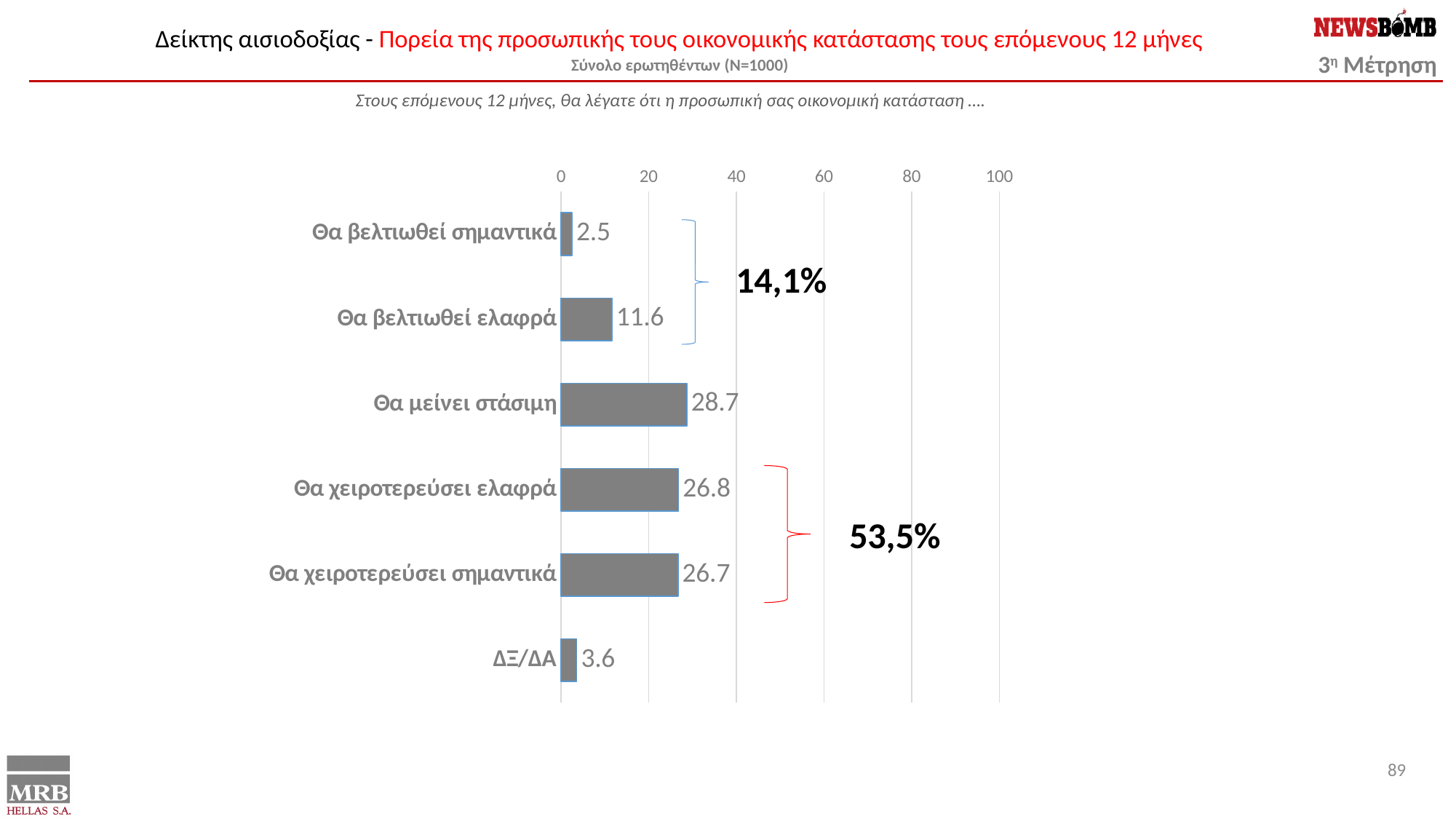
What is the value for "Θα μείνει στάσιμη"? 28.7 Which category has the lowest value? Θα βελτιωθεί σημαντικά How many categories are shown in the chart? 6 Is the value for "Θα χειροτερεύσει ελαφρά" greater or less than 20? greater Which category has the highest value? Θα μείνει στάσιμη Which is larger: the value for "Θα βελτιωθεί ελαφρά" or the value for "ΔΞ/ΔΑ"? Θα βελτιωθεί ελαφρά What combined percentage is shown next to the red bracket grouping the two "Θα χειροτερεύσει" categories? 53,5% What kind of chart is shown on the slide? bar chart What is the difference between the values for "Θα μείνει στάσιμη" and "Θα βελτιωθεί ελαφρά"? 17.1 What combined percentage is shown next to the blue bracket grouping the two "Θα βελτιωθεί" categories? 14,1% What is the value for "Θα βελτιωθεί ελαφρά"? 11.6 What is the value for "ΔΞ/ΔΑ"? 3.6